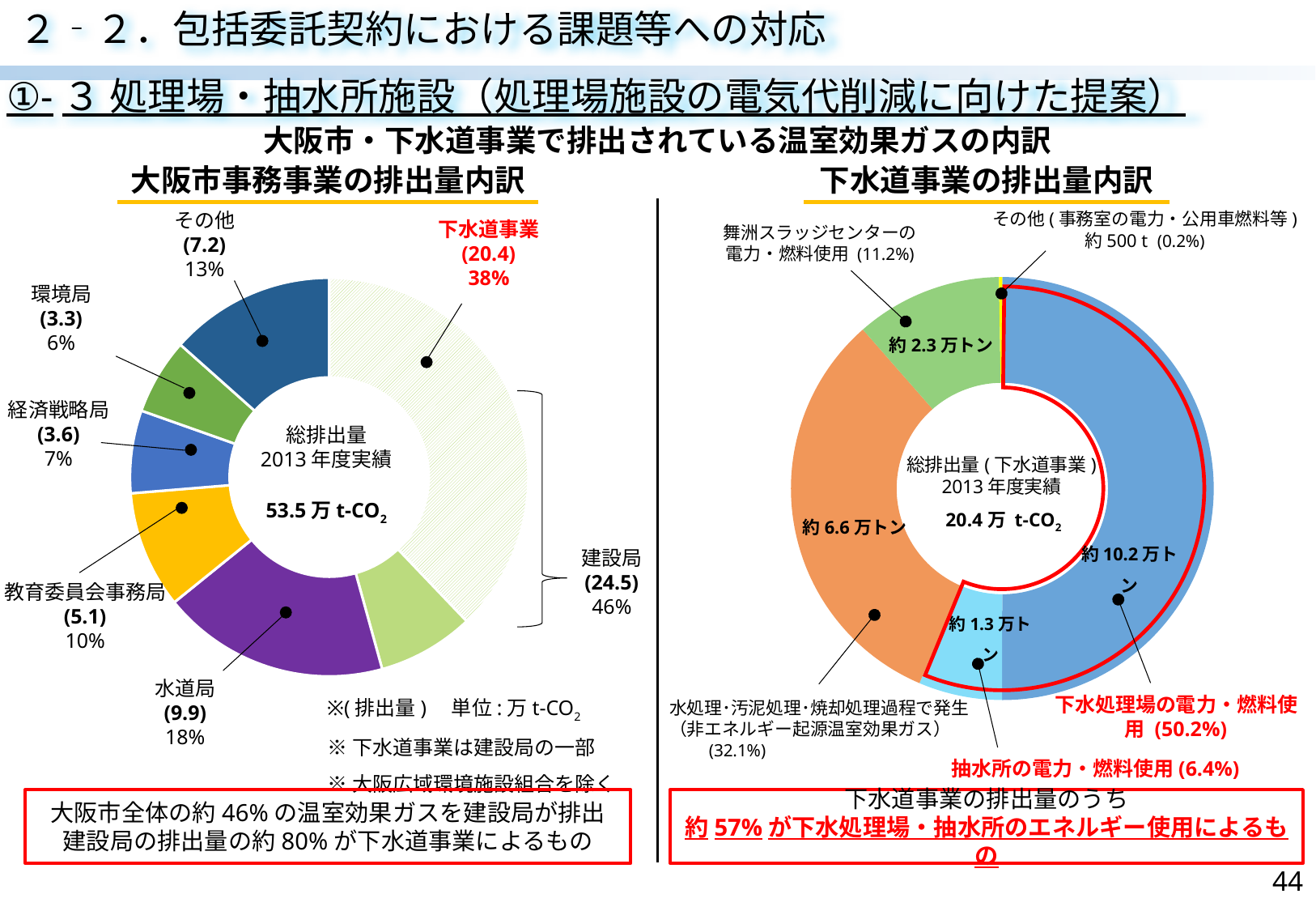
「大阪市事務事業の排出量内訳」のグラフで、建設局の割合は何％ですか？ 46% 「下水道事業の排出量内訳」のグラフで、下水処理場の電力・燃料使用の割合は何％ですか？ 50.2% 「下水道事業の排出量内訳」のグラフで、割合が最も大きい項目はどれですか？ 下水処理場の電力・燃料使用 「大阪市事務事業の排出量内訳」のグラフで、その他と水道局ではどちらの排出量が大きいですか？ 水道局 「下水道事業の排出量内訳」のグラフで、その他（事務室の電力・公用車燃料等）の割合は何％ですか？ 0.2% 「大阪市事務事業の排出量内訳」のグラフで、割合が最も小さい部局はどれですか？ 環境局 「大阪市事務事業の排出量内訳」のグラフで、水道局の排出量はいくらですか？ 9.9 「大阪市事務事業の排出量内訳」のグラフで、総排出量（2013年度実績）はいくらですか？ 53.5万 t-CO2 「下水道事業の排出量内訳」のグラフで、舞洲スラッジセンターの電力・燃料使用の排出量はいくらですか？ 約2.3万トン 「大阪市事務事業の排出量内訳」のグラフで、教育委員会事務局と経済戦略局の排出量の差はいくらですか？ 1.5 「下水道事業の排出量内訳」のグラフで、抽水所の電力・燃料使用と舞洲スラッジセンターの電力・燃料使用ではどちらの割合が大きいですか？ 舞洲スラッジセンターの電力・燃料使用 このスライドの2つのグラフはどのような種類のグラフですか？ ドーナツ（円）グラフ